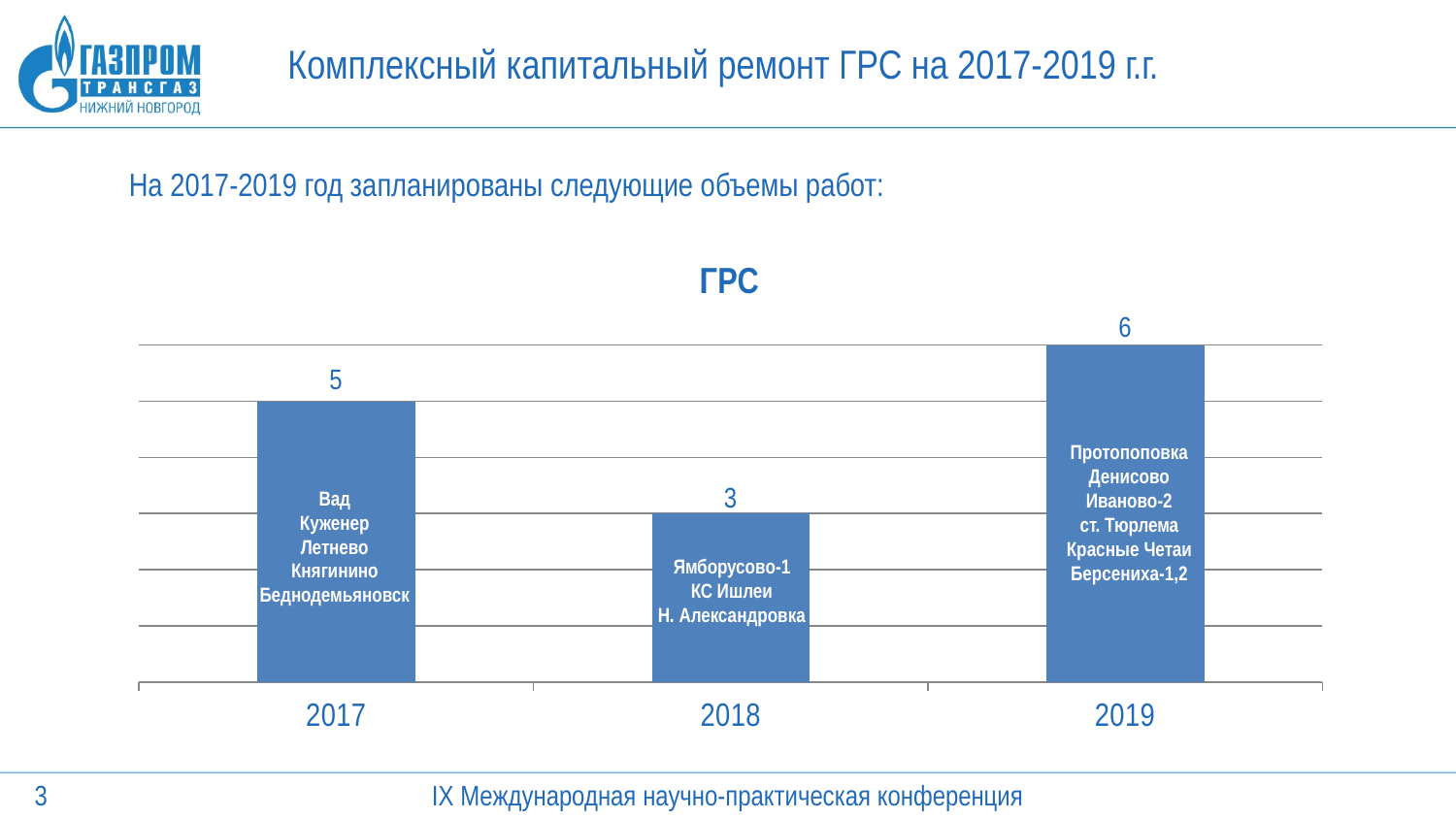
How many years are shown on the x axis? 3 What is the value for 2017? 5 Which is larger, the value for 2017 or the value for 2019? 2019 Which station names are listed inside the bar for 2018? Ямборусово-1, КС Ишлеи, Н. Александровка What is the difference between the values for 2017 and 2018? 2 What is the difference between the values for 2019 and 2018? 3 What is the value for 2019? 6 What kind of chart is shown? bar chart Which year has the lowest value? 2018 Which year has the highest value? 2019 What is the value for 2018? 3 What is the title of the chart? ГРС